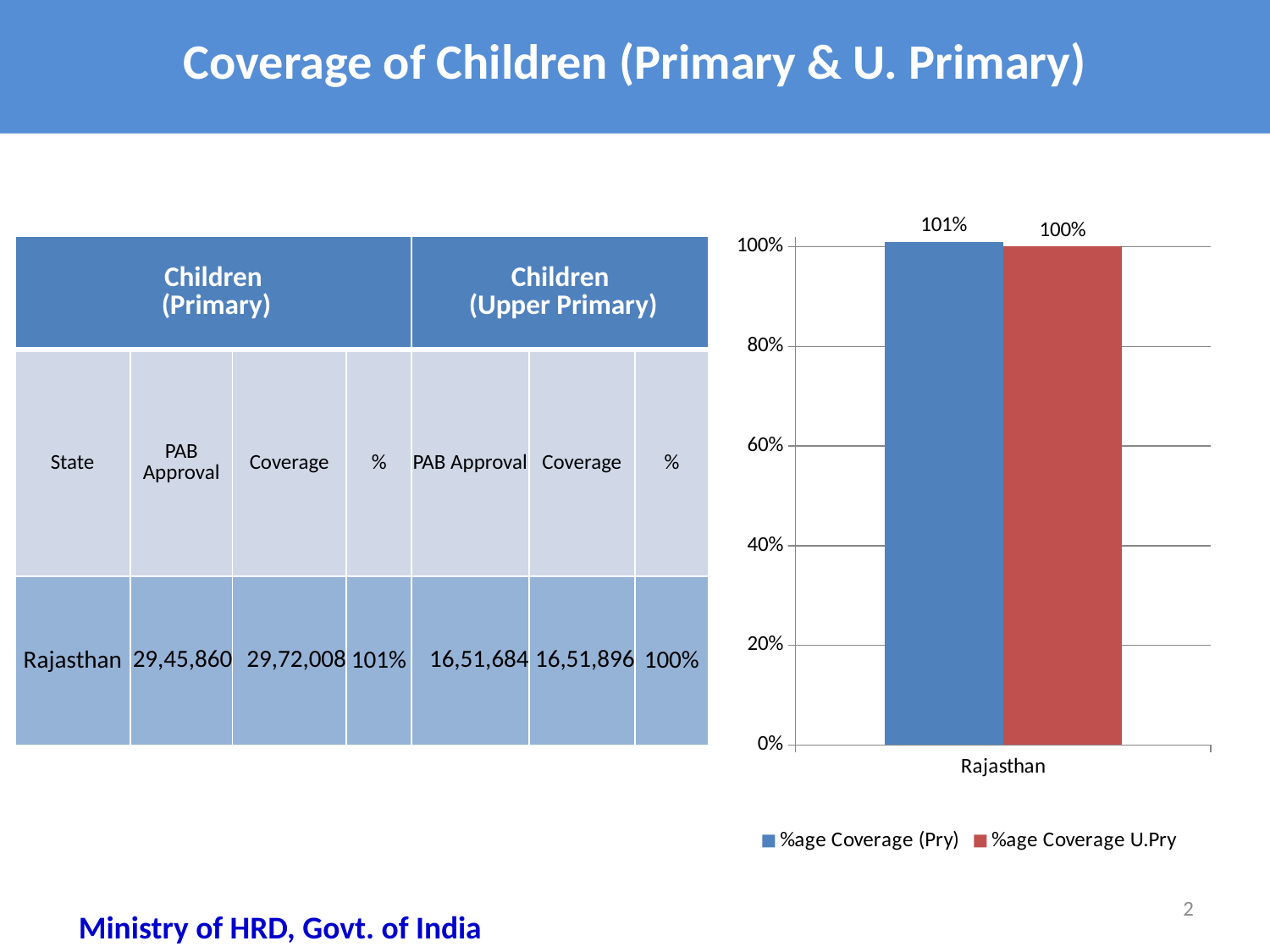
What kind of chart is shown on the slide? Bar chart What is the difference between %age Coverage (Pry) and %age Coverage U.Pry for Rajasthan? 1% What colour is the bar for %age Coverage U.Pry? Red What is the value of %age Coverage (Pry) for Rajasthan? 101% Which series has the lowest value in the chart? %age Coverage U.Pry Is the value for %age Coverage U.Pry for Rajasthan greater or less than 80%? greater Which category is shown on the x axis of the chart? Rajasthan What is the value of %age Coverage U.Pry for Rajasthan? 100% Which series has the higher value for Rajasthan, %age Coverage (Pry) or %age Coverage U.Pry? %age Coverage (Pry) Which series has the highest value in the chart? %age Coverage (Pry) How many series does the chart legend list? 2 How many categories are shown on the x axis of the chart? 1